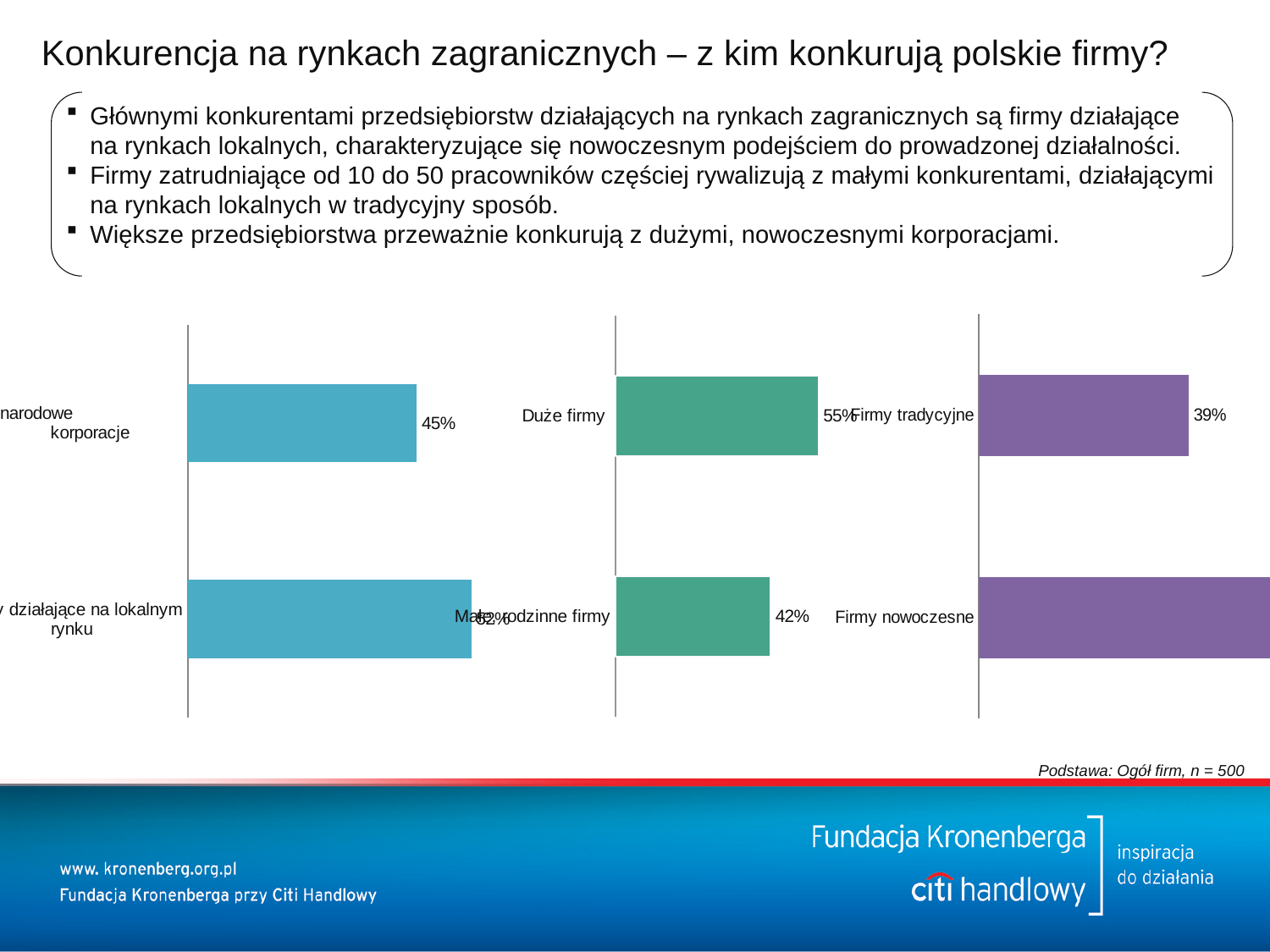
In the left chart, which bar is longer, the top bar (korporacje) or the bottom bar (firmy działające na lokalnym rynku)? The bottom bar (firmy działające na lokalnym rynku) In the left chart, what is the value shown for the top bar (korporacje)? 45% What type of chart is used on this slide? Bar chart In the right chart, what is the value for Firmy tradycyjne? 39% In the right chart, which bar is longer, Firmy tradycyjne or Firmy nowoczesne? Firmy nowoczesne In the middle chart, what is the value for Małe rodzinne firmy? 42% What colour are the bars in the right chart? Purple How many categories does the middle chart show? 2 How many separate charts are shown on the slide? 3 In the middle chart, what is the value for Duże firmy? 55% In the middle chart, what is the difference between the values for Duże firmy and Małe rodzinne firmy? 13 percentage points In the middle chart, which category has the higher value? Duże firmy